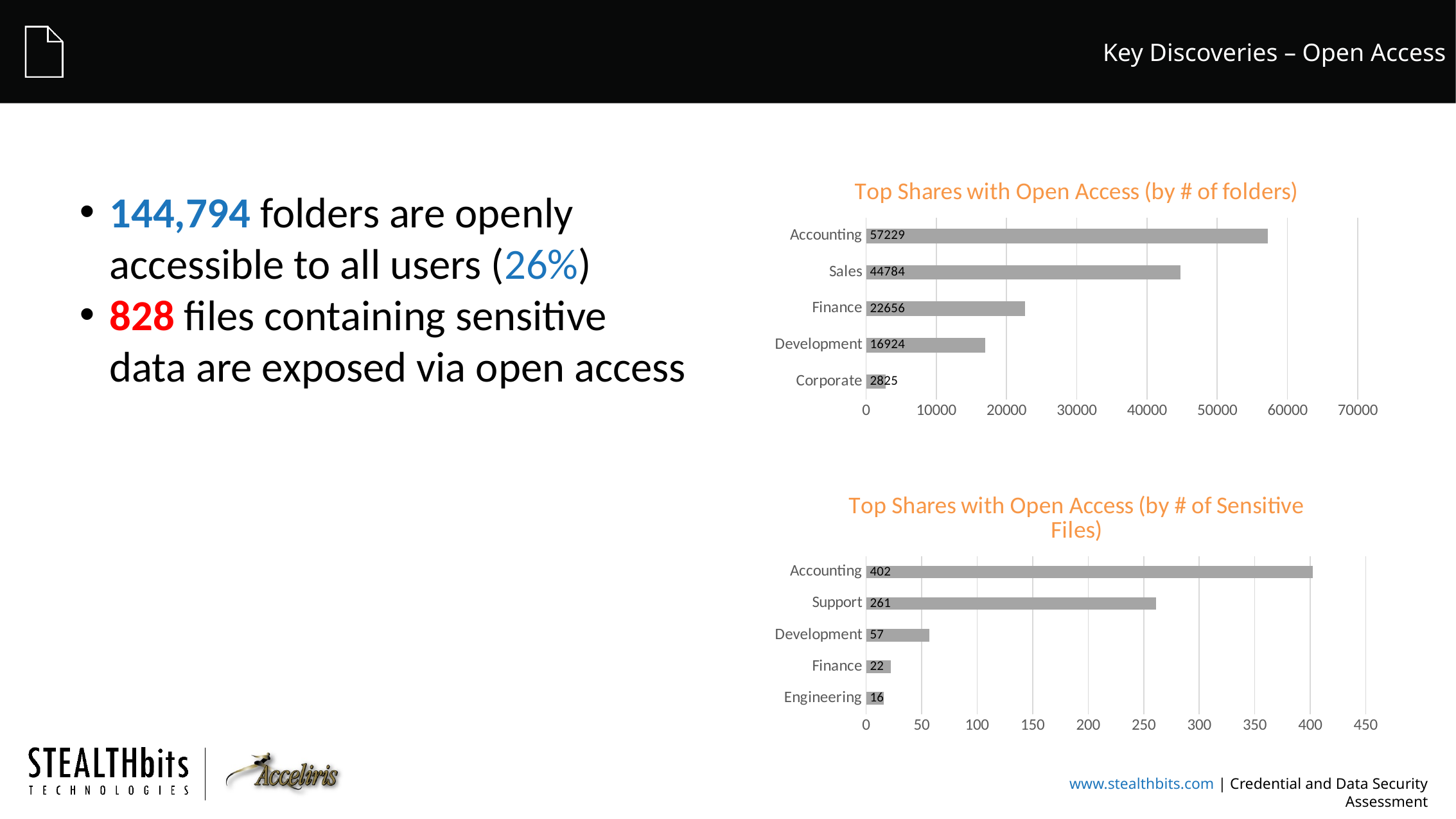
In the 'Top Shares with Open Access (by # of Sensitive Files)' chart, which is larger, Development or Finance? Development In the 'Top Shares with Open Access (by # of Sensitive Files)' chart, what is the value for Support? 261 In the 'Top Shares with Open Access (by # of folders)' chart, is the value for Finance greater or less than 20000? greater In the 'Top Shares with Open Access (by # of folders)' chart, which share has the lowest number of folders? Corporate In the 'Top Shares with Open Access (by # of Sensitive Files)' chart, which share has the fewest sensitive files? Engineering In the 'Top Shares with Open Access (by # of folders)' chart, how many shares are listed? 5 What type of chart is the 'Top Shares with Open Access (by # of Sensitive Files)' chart? Bar chart In the 'Top Shares with Open Access (by # of Sensitive Files)' chart, what is the value for Development? 57 In the 'Top Shares with Open Access (by # of folders)' chart, what is the difference between Accounting and Sales? 12445 In the 'Top Shares with Open Access (by # of Sensitive Files)' chart, what is the difference between Accounting and Support? 141 In the 'Top Shares with Open Access (by # of folders)' chart, which share has the highest number of folders? Accounting In the 'Top Shares with Open Access (by # of folders)' chart, what is the value for Sales? 44784